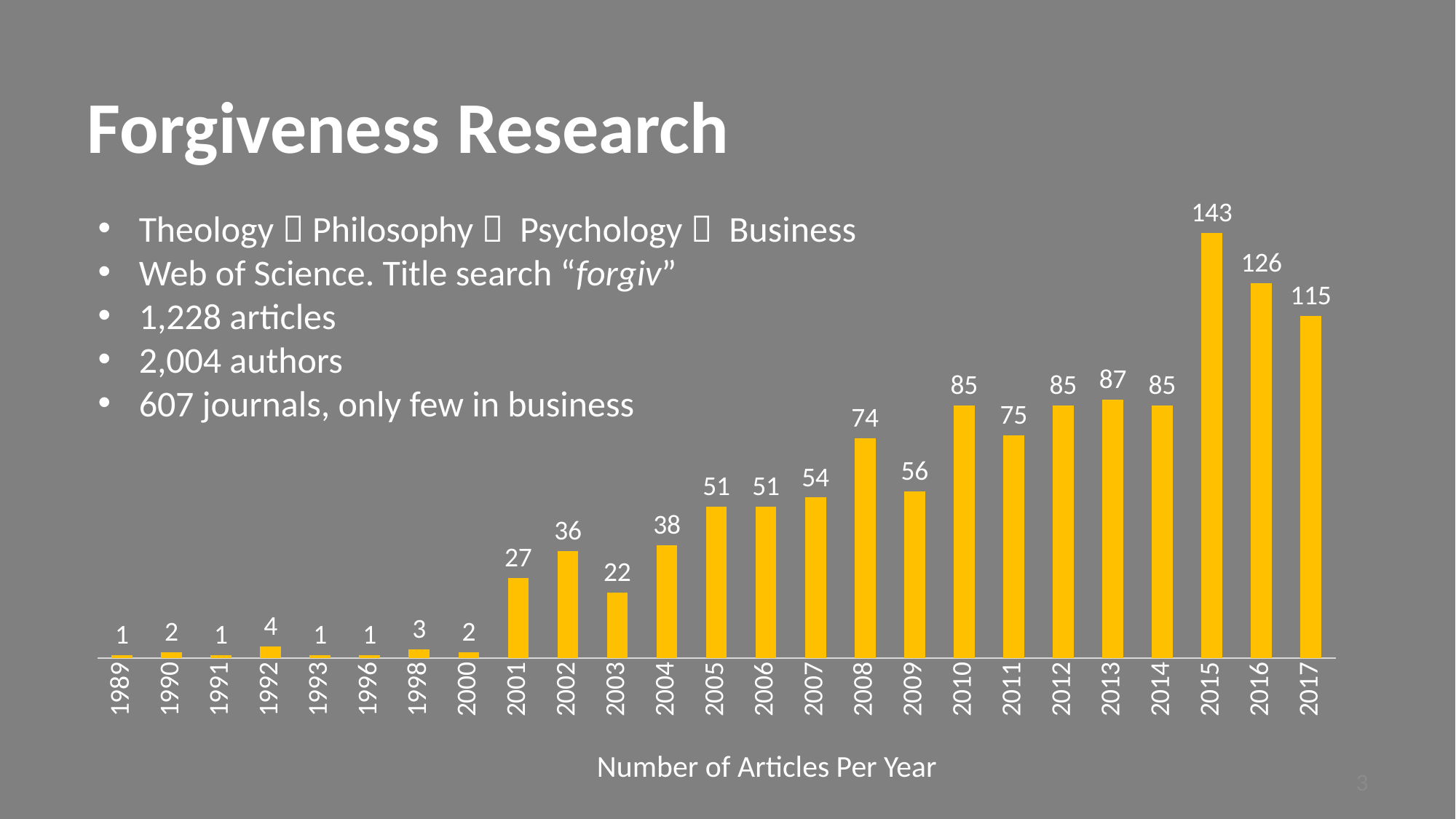
Which year has more articles, 2002 or 2004? 2004 What is the difference in the number of articles between 2016 and 2017? 11 Do the number of articles generally rise or fall from 1989 to 2015? rise Which year has more articles, 2011 or 2013? 2013 What kind of chart is shown on the slide? bar chart What is the caption shown below the chart? Number of Articles Per Year What is the number of articles for 2015? 143 What is the number of articles for 2008? 74 What is the difference in the number of articles between 2015 and 2014? 58 Which year has the highest number of articles? 2015 How many years are shown on the x axis of the chart? 25 What is the number of articles for 2003? 22